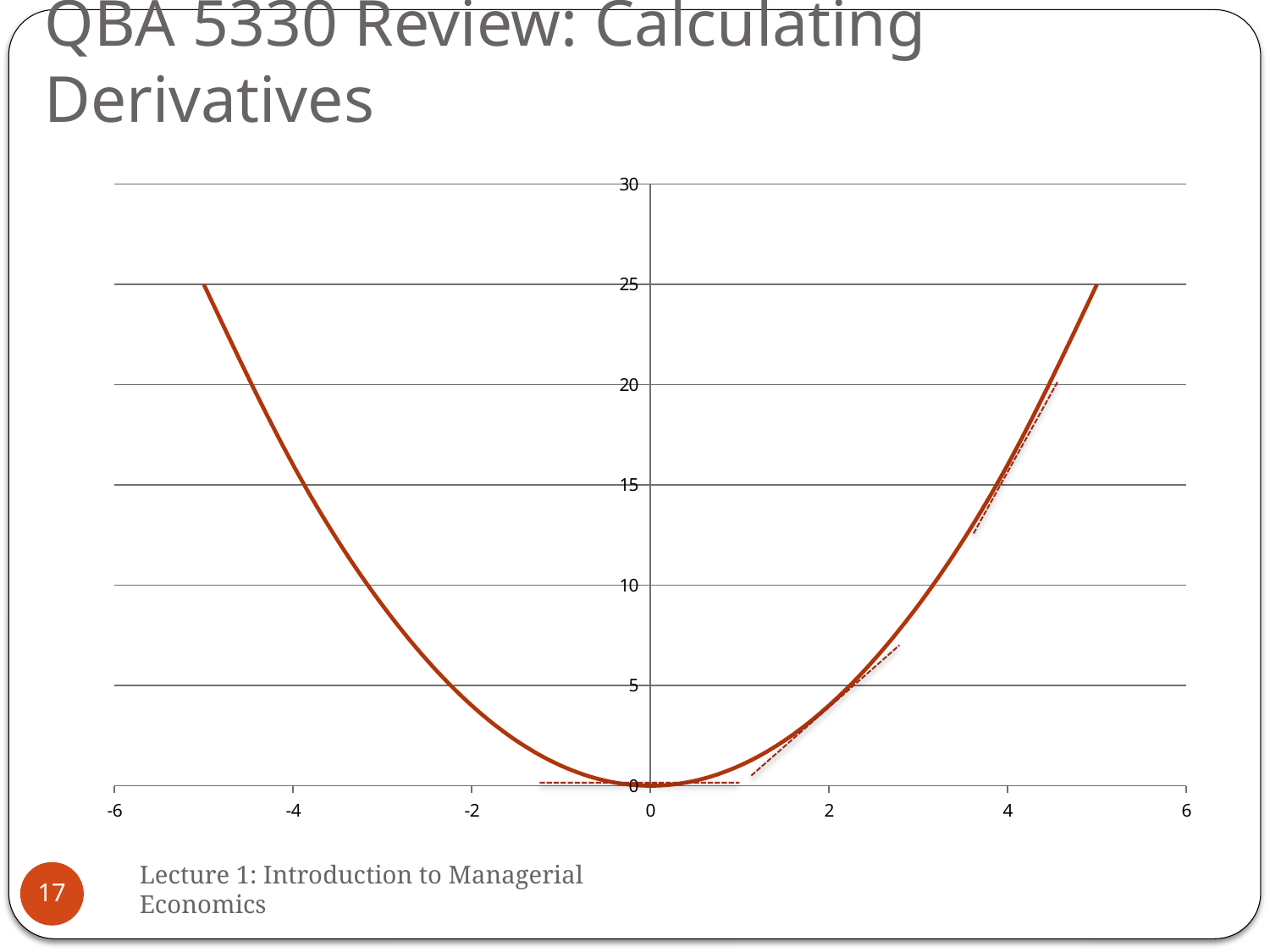
Is the value of the curve at x = 2 greater or less than 10? less What is the maximum value shown on the y axis? 30 What is the highest y value the plotted curve reaches? 25 Is the value of the curve at x = -4 greater or less than 10? greater Does the curve rise or fall as x increases from 0 to 4? rise How many dashed tangent line segments are drawn on the curve? 3 At what x value does the plotted curve reach its lowest point? 0 Is the value of the curve at x = 4 greater or less than 10? greater Does the curve rise or fall as x increases from -4 to 0? fall What is the value of the curve at x = 0? 0 What kind of chart is shown on the slide? line chart Which is larger, the value of the curve at x = 4 or at x = 2? x = 4